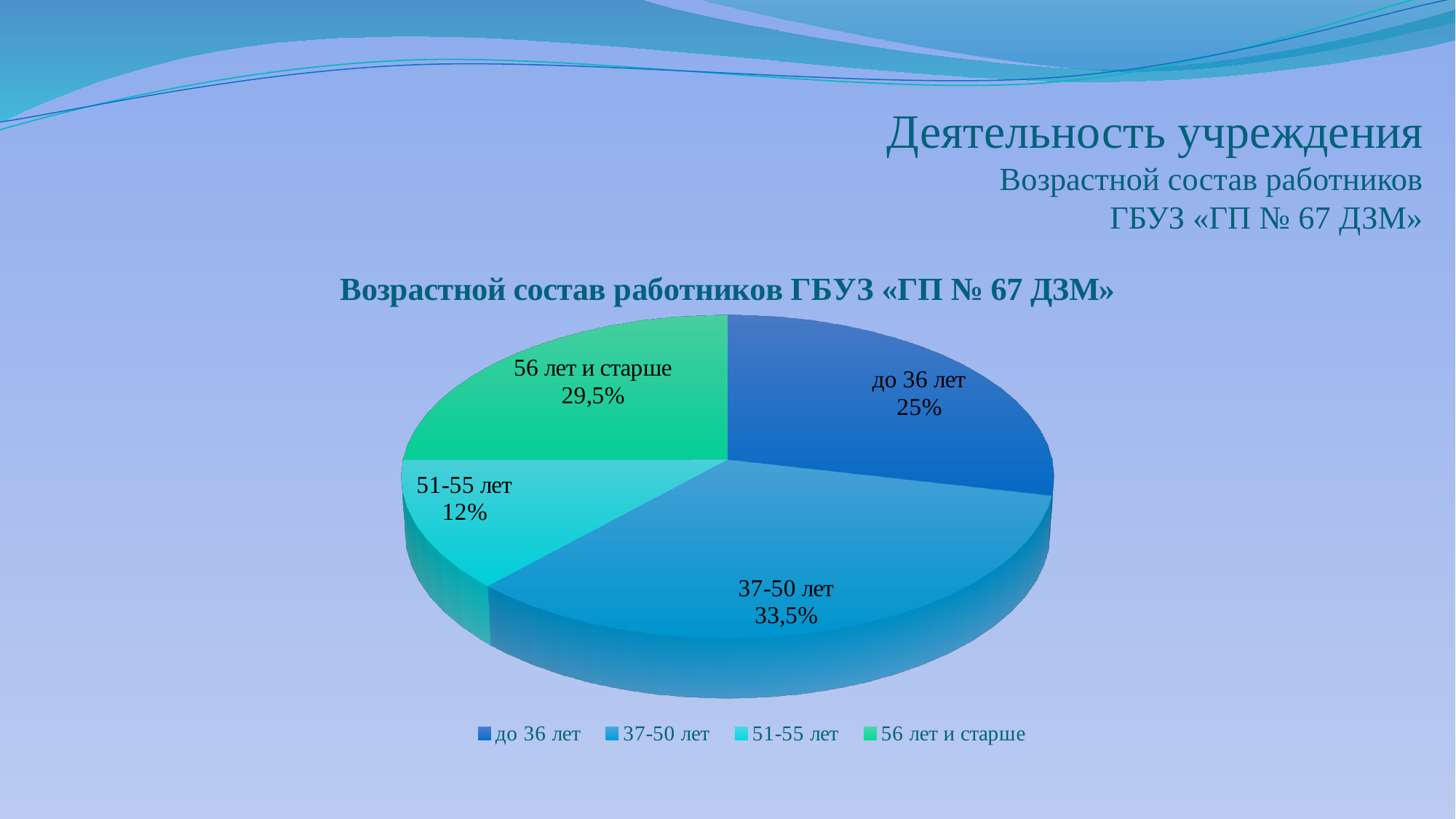
Which group has a larger share: "до 36 лет" or "56 лет и старше"? 56 лет и старше Which age group has the largest share of workers? 37-50 лет Which age group has the smallest share of workers? 51-55 лет What is the title of the chart? Возрастной состав работников ГБУЗ «ГП № 67 ДЗМ» What colour is the "56 лет и старше" slice in the pie chart? Green What share of workers is in the "до 36 лет" age group? 25% What share of workers is in the "56 лет и старше" age group? 29,5% What share of workers is in the "51-55 лет" age group? 12% What share of workers is in the "37-50 лет" age group? 33,5% What type of chart is shown on the slide? Pie chart How many age groups are shown in the pie chart? 4 What is the difference in percentage points between the "37-50 лет" and "51-55 лет" groups? 21,5